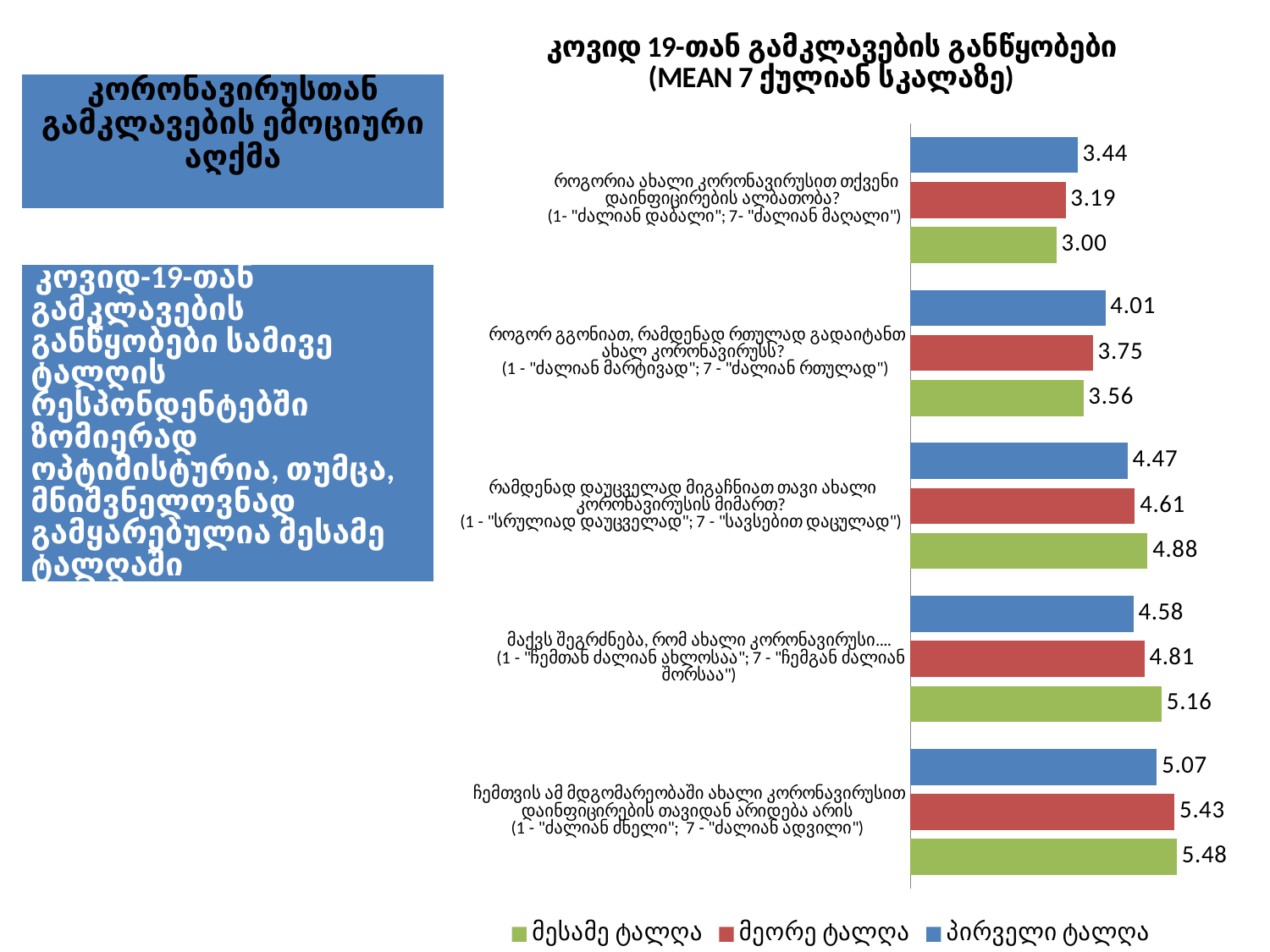
What colour represents მეორე ტალღა in the chart? red How many question categories are plotted on the chart? 5 What is the value for მეორე ტალღა for the category 'მაქვს შეგრძნება, რომ ახალი კორონავირუსი....'? 4.81 For the category 'რამდენად დაუცველად მიგაჩნიათ თავი ახალი კორონავირუსის მიმართ?', which is larger: მეორე ტალღა or მესამე ტალღა? მესამე ტალღა What is the value for პირველი ტალღა for the category 'როგორია ახალი კორონავირუსით თქვენი დაინფიცირების ალბათობა?'? 3.44 What is the value for მესამე ტალღა for the category 'ჩემთვის ამ მდგომარეობაში ახალი კორონავირუსით დაინფიცირების თავიდან არიდება არის'? 5.48 Which category has the lowest value for პირველი ტალღა? როგორია ახალი კორონავირუსით თქვენი დაინფიცირების ალბათობა? For the category 'როგორ გგონიათ, რამდენად რთულად გადაიტანთ ახალ კორონავირუსს?', which is larger: პირველი ტალღა or მესამე ტალღა? პირველი ტალღა What is the difference between the მესამე ტალღა and პირველი ტალღა values for the category 'მაქვს შეგრძნება, რომ ახალი კორონავირუსი....'? 0.58 How many series does the legend list? 3 What type of chart is shown on the slide? bar chart Which category has the highest value for მესამე ტალღა? ჩემთვის ამ მდგომარეობაში ახალი კორონავირუსით დაინფიცირების თავიდან არიდება არის